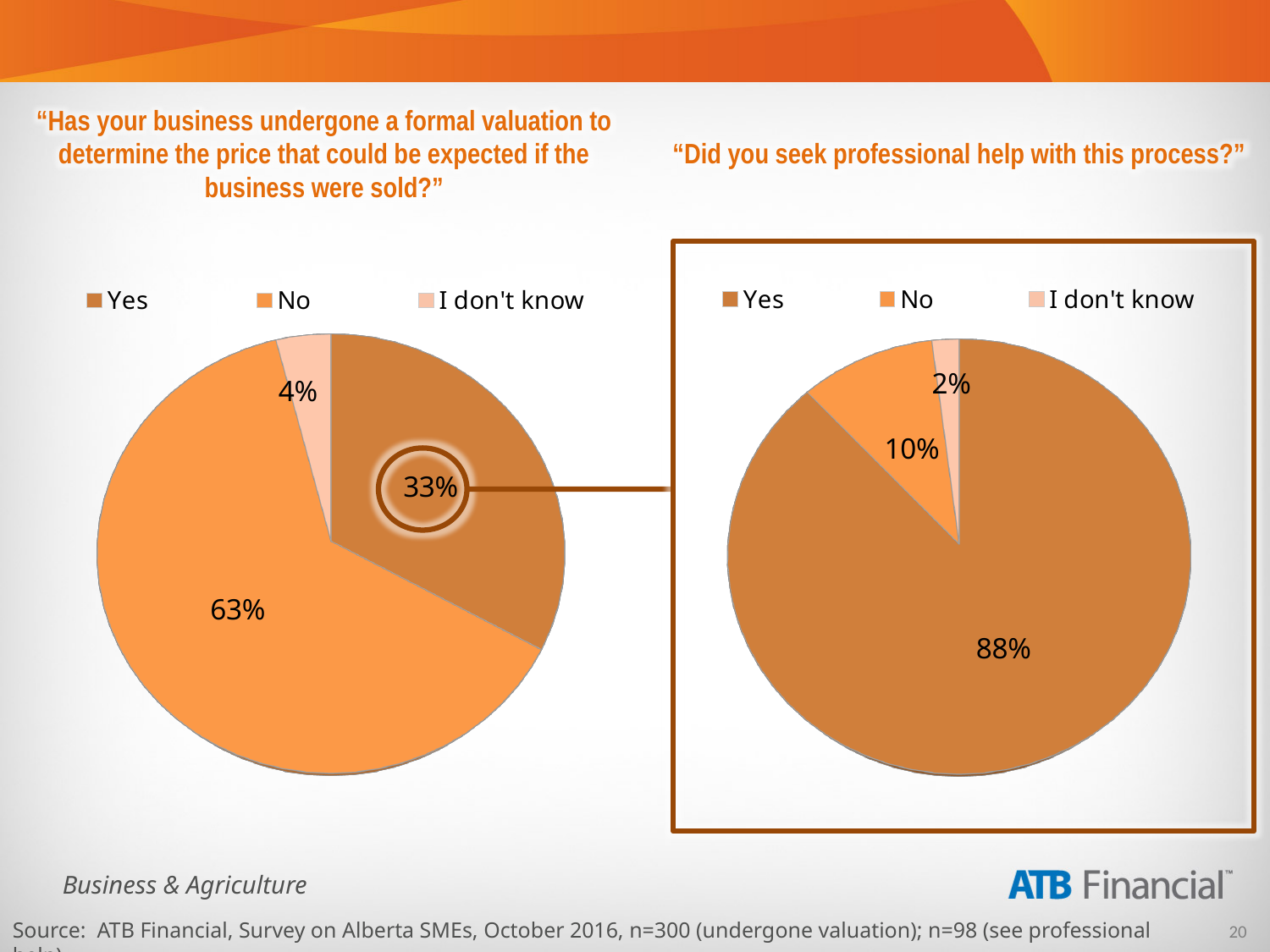
In the right pie chart ("Did you seek professional help with this process?"), what share of respondents answered No? 10% In the left pie chart ("Has your business undergone a formal valuation..."), what share of respondents answered Yes? 33% In the left pie chart ("Has your business undergone a formal valuation..."), what share of respondents answered I don't know? 4% In the right pie chart ("Did you seek professional help with this process?"), which is larger, the Yes share or the No share? Yes In the left pie chart ("Has your business undergone a formal valuation..."), what share of respondents answered No? 63% What type of chart is used on the left side of the slide? Pie chart In the right pie chart ("Did you seek professional help with this process?"), which response has the smallest share? I don't know In the right pie chart ("Did you seek professional help with this process?"), what share of respondents answered Yes? 88% How many entries does the legend of the right pie chart ("Did you seek professional help with this process?") list? 3 In the left pie chart ("Has your business undergone a formal valuation..."), what is the difference in percentage points between the No and Yes shares? 30 In the left pie chart ("Has your business undergone a formal valuation..."), which response has the largest share? No In the right pie chart ("Did you seek professional help with this process?"), what share of respondents answered I don't know? 2%